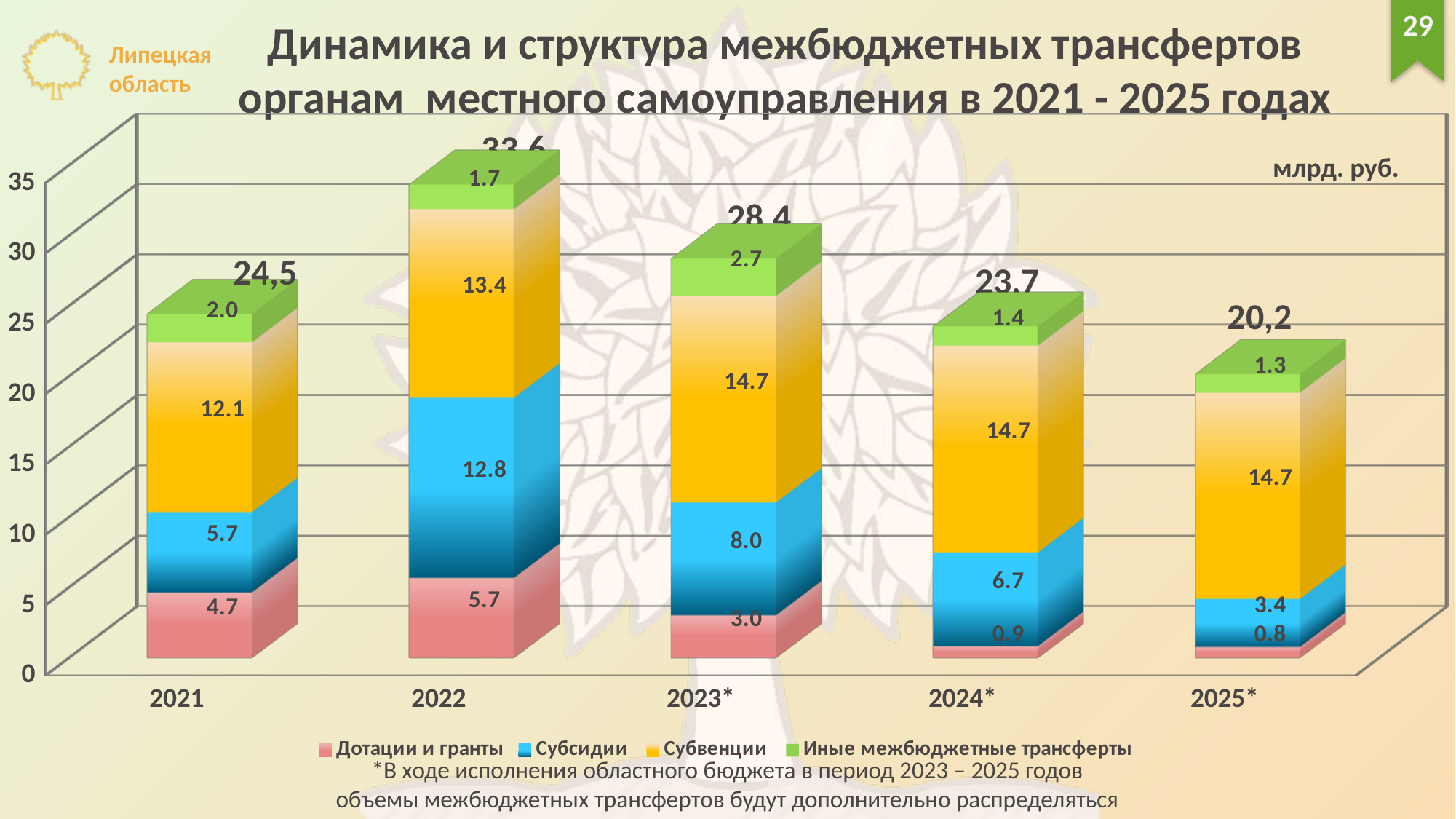
Do the bar totals rise or fall from 2022 to 2025*? Fall What is the value of Субсидии for 2022? 12.8 How many series does the legend list? 4 What is the difference between the Субсидии value for 2024* and for 2021? 1.0 What kind of chart is shown on the slide? Stacked bar chart Which year has the lowest total of intergovernmental transfers? 2025* What is the value of Дотации и гранты for 2025*? 0.8 Which is larger: Иные межбюджетные трансферты in 2023* or in 2021? 2023* What is the value of Субвенции for 2021? 12.1 Which year has the highest total of intergovernmental transfers? 2022 What is the total of the stacked bar for 2023*? 28,4 How many years (categories) are shown on the x axis? 5